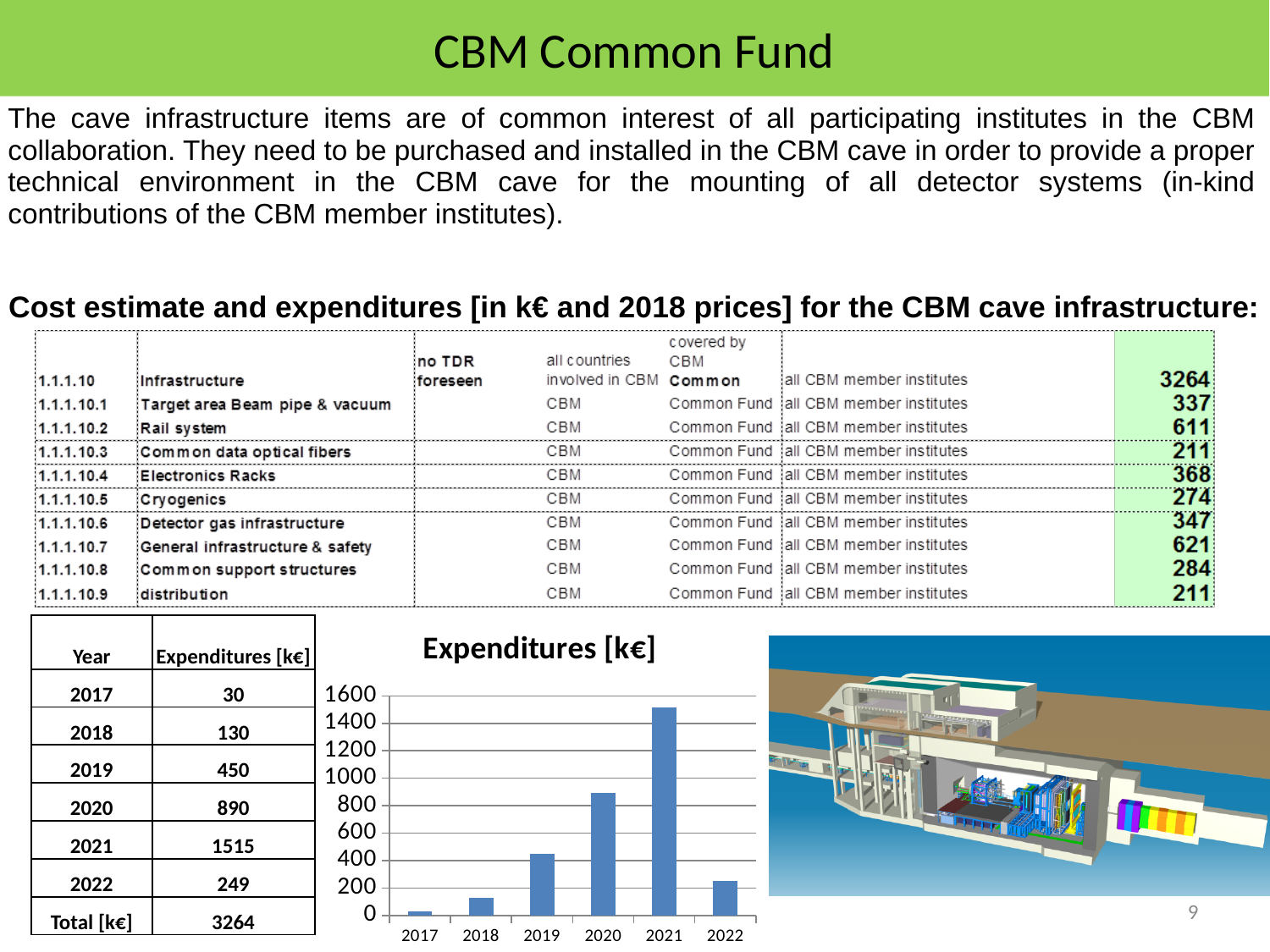
Which year has the lowest expenditure in the Expenditures [k€] chart? 2017 Is the expenditure for 2021 greater or less than 1400? greater How many years are shown on the x axis of the Expenditures [k€] chart? 6 Do the expenditures rise or fall from 2017 to 2021? rise What is the expenditure for 2021 in k€, as given in the table next to the chart? 1515 Is the expenditure for 2020 greater or less than 1000? less Which year has the larger expenditure, 2020 or 2022? 2020 What is the title of the chart on the slide? Expenditures [k€] What kind of chart is the Expenditures [k€] chart? bar chart Which year has the highest expenditure in the Expenditures [k€] chart? 2021 Is the expenditure for 2019 greater or less than 400? greater What is the expenditure for 2022 in k€, as given in the table next to the chart? 249